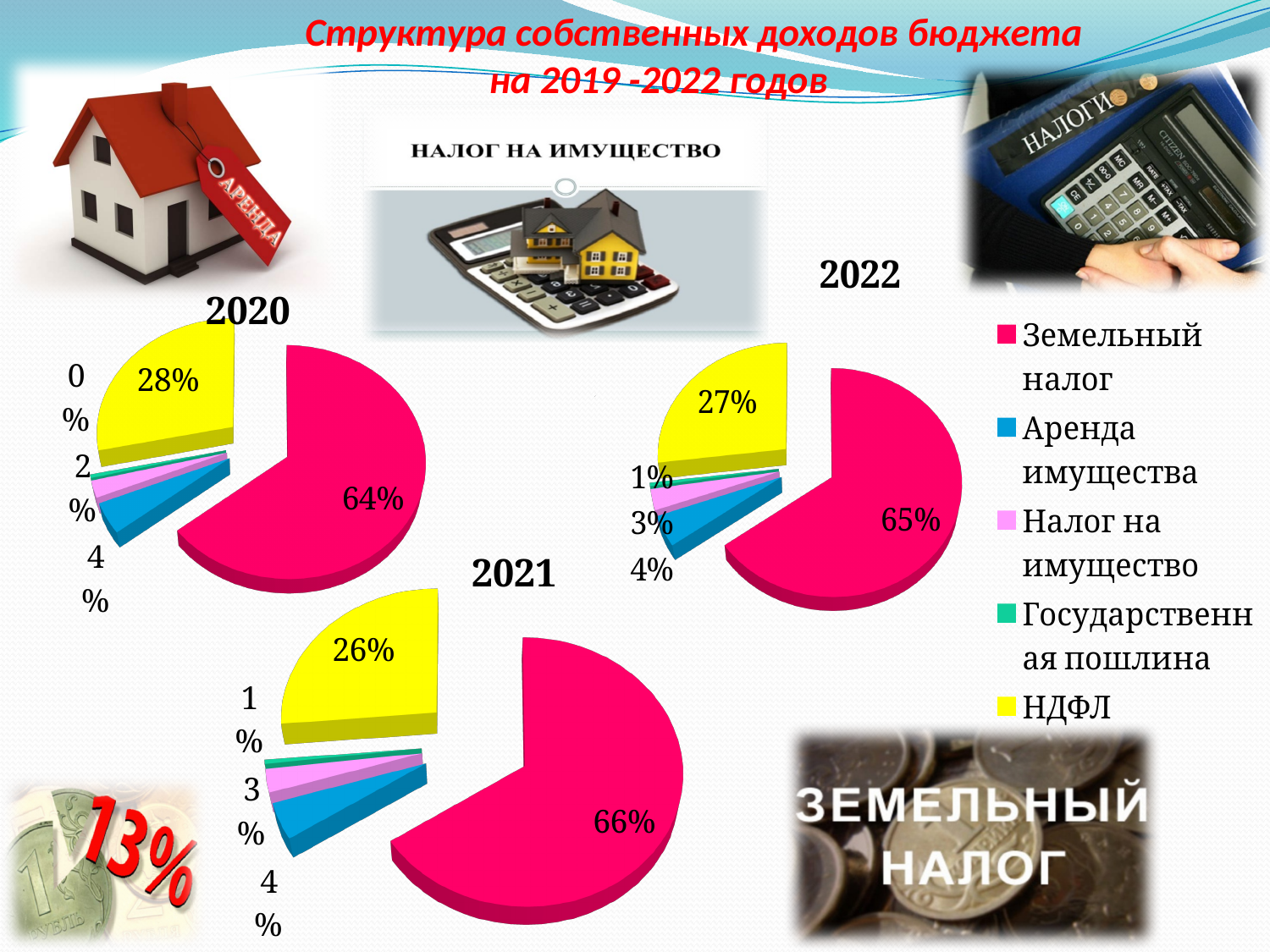
Which colour represents НДФЛ in the pie charts? Yellow In the 2021 pie chart, what share does НДФЛ have? 26% How many pie charts are on the slide? 3 In the 2020 pie chart, which category has the largest share? Земельный налог In the 2022 pie chart, what share does НДФЛ have? 27% In the 2020 pie chart, what share does Земельный налог have? 64% How many categories does the legend list? 5 In the 2021 pie chart, what is the difference between the shares of Земельный налог and НДФЛ? 40% In the 2022 pie chart, which is larger: the share of Аренда имущества or the share of Налог на имущество? Аренда имущества What kind of charts are shown on the slide? Pie charts In the 2021 pie chart, which category has the smallest share? Государственная пошлина In the 2022 pie chart, what share does Земельный налог have? 65%